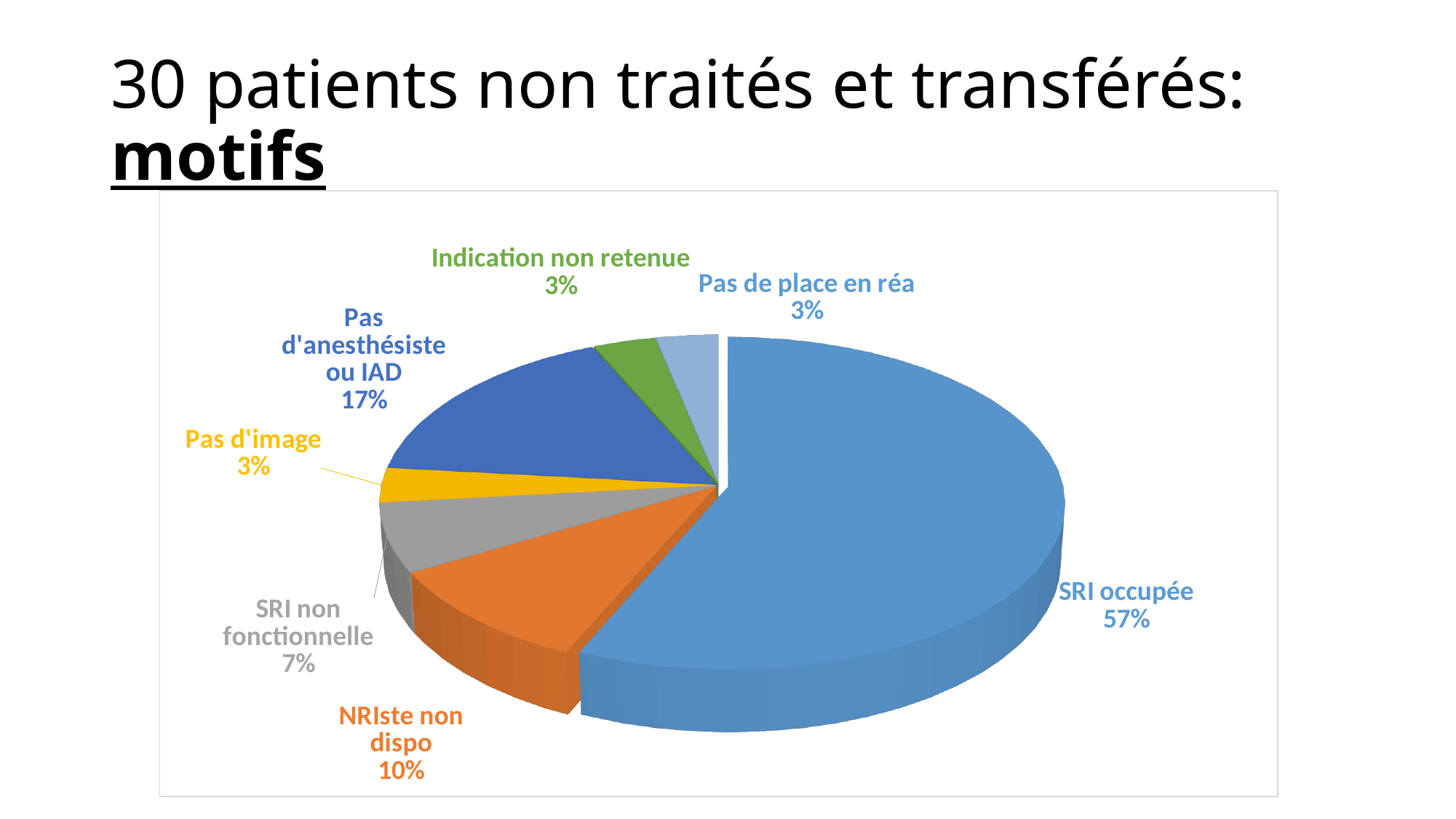
Which is larger, the share for "NRIste non dispo" or the share for "SRI non fonctionnelle"? NRIste non dispo What is the difference in percentage points between "SRI occupée" and "Pas d'anesthésiste ou IAD"? 40 What share of the pie does "NRIste non dispo" represent? 10% What is the difference in percentage points between "Pas d'anesthésiste ou IAD" and "NRIste non dispo"? 7 What share of the pie does "Pas d'anesthésiste ou IAD" represent? 17% What share of the pie does "SRI occupée" represent? 57% What is the title of the slide containing the pie chart? 30 patients non traités et transférés: motifs What share of the pie does "Pas d'image" represent? 3% What kind of chart is shown on the slide? Pie chart How many slices does the pie chart have? 7 What share of the pie does "SRI non fonctionnelle" represent? 7% Which category has the largest slice of the pie? SRI occupée